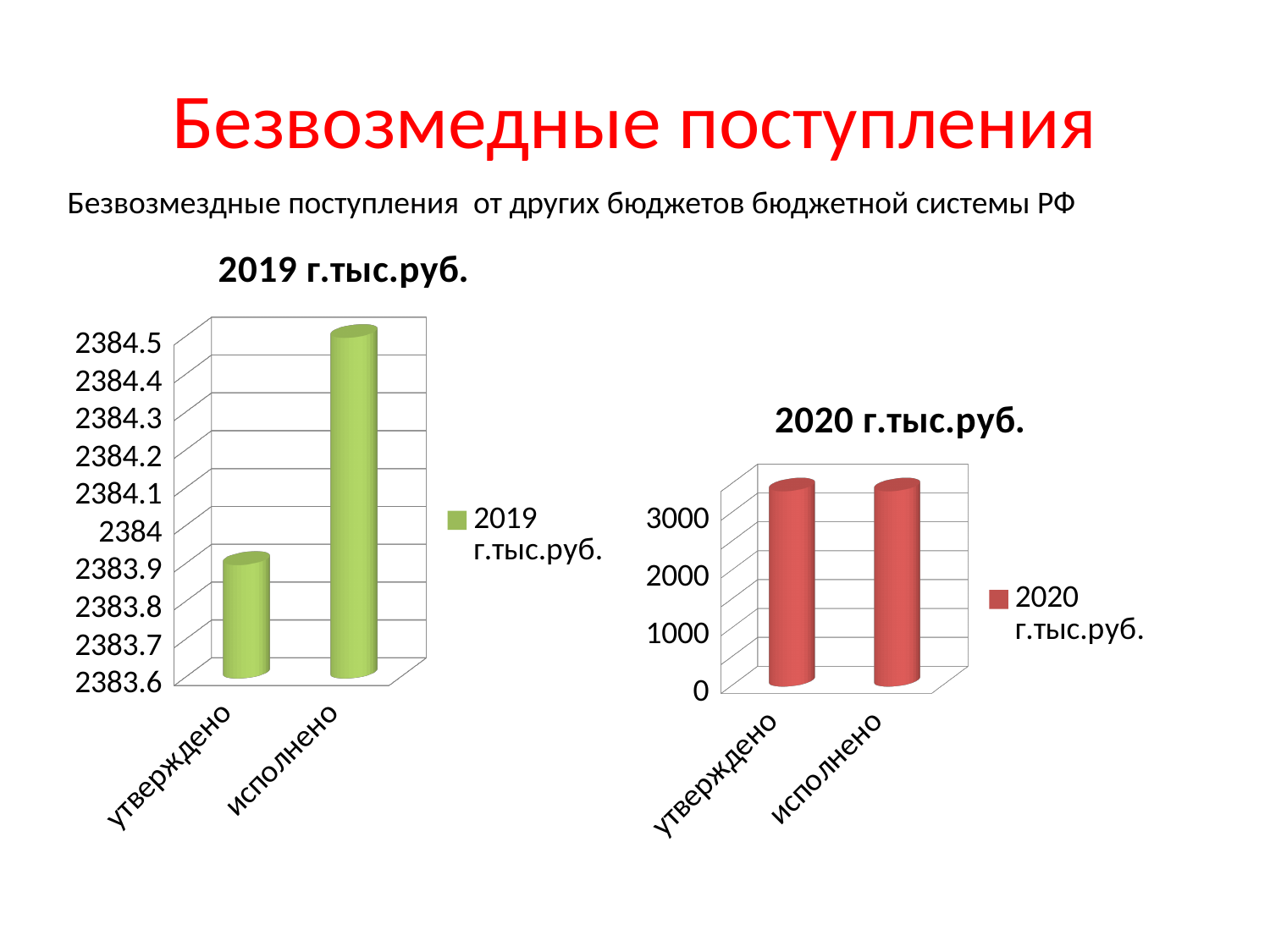
In the "2019 г.тыс.руб." chart, is the value for утверждено greater or less than 2384? less In the "2019 г.тыс.руб." chart, which is larger: утверждено or исполнено? исполнено In the "2020 г.тыс.руб." chart, is the value for утверждено greater or less than 3000? greater What kind of chart is the "2019 г.тыс.руб." chart? bar chart In the "2019 г.тыс.руб." chart, is the value for исполнено greater or less than 2384.2? greater In the "2019 г.тыс.руб." chart, which category has the lowest value? утверждено How many categories are shown on the x axis of the "2019 г.тыс.руб." chart? 2 What is the legend entry of the "2020 г.тыс.руб." chart? 2020 г.тыс.руб. How many series does the legend of the "2020 г.тыс.руб." chart list? 1 What kind of chart is the "2020 г.тыс.руб." chart? bar chart In the "2019 г.тыс.руб." chart, do the values rise or fall from утверждено to исполнено? rise In the "2019 г.тыс.руб." chart, which category has the highest value? исполнено